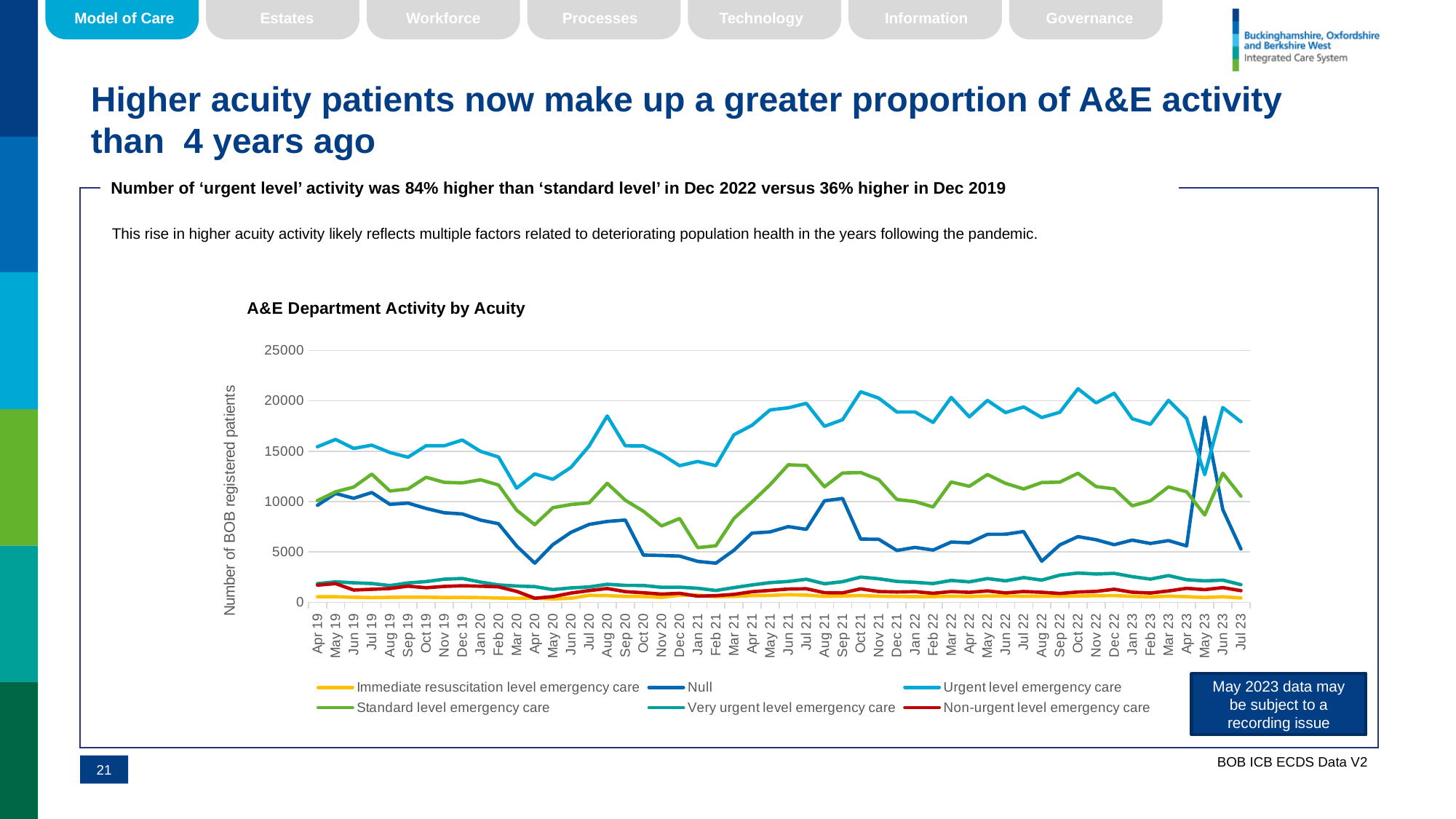
In Jul 23, which is larger: Null or Standard level emergency care? Standard level emergency care Which series is the highest across the 'A&E Department Activity by Acuity' chart in Oct 22? Urgent level emergency care In Dec 22, which is larger: Urgent level emergency care or Standard level emergency care? Urgent level emergency care How many series does the legend of the 'A&E Department Activity by Acuity' chart list? 6 Is the value for Standard level emergency care in Apr 20 greater or less than 10000? less What is the y-axis label of the 'A&E Department Activity by Acuity' chart? Number of BOB registered patients What kind of chart is 'A&E Department Activity by Acuity'? line chart Is the value for Null in Apr 20 greater or less than 5000? less Is the value for Urgent level emergency care in Apr 19 greater or less than 15000? greater Does the Urgent level emergency care line generally rise or fall from Apr 19 to Jul 23? rise